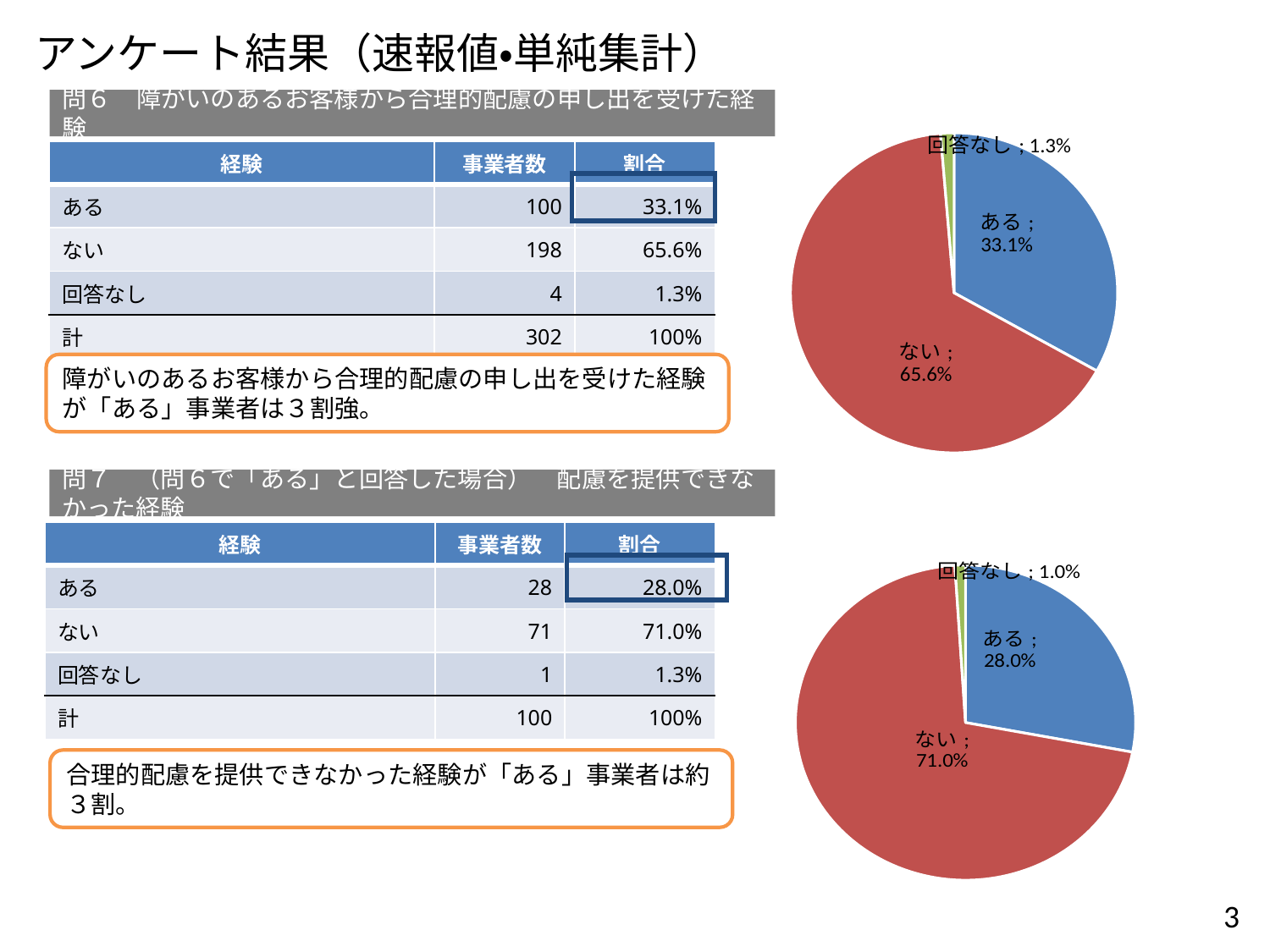
In the bottom pie chart, what share is labelled for 回答なし? 1.0% What kind of chart is the top chart on the slide? Pie chart In the top pie chart, which slice is the smallest? 回答なし In the bottom pie chart, which is larger, the slice for ある or the slice for ない? ない In the top pie chart, what share is labelled for ある? 33.1% In the top pie chart, what share is labelled for 回答なし? 1.3% In the top pie chart, what share is labelled for ない? 65.6% In the bottom pie chart, what share is labelled for ある? 28.0% In the bottom pie chart, what share is labelled for ない? 71.0% In the top pie chart, which slice is the largest? ない How many slices does the bottom pie chart have? 3 In the top pie chart, what is the difference between the shares for ない and ある? 32.5%